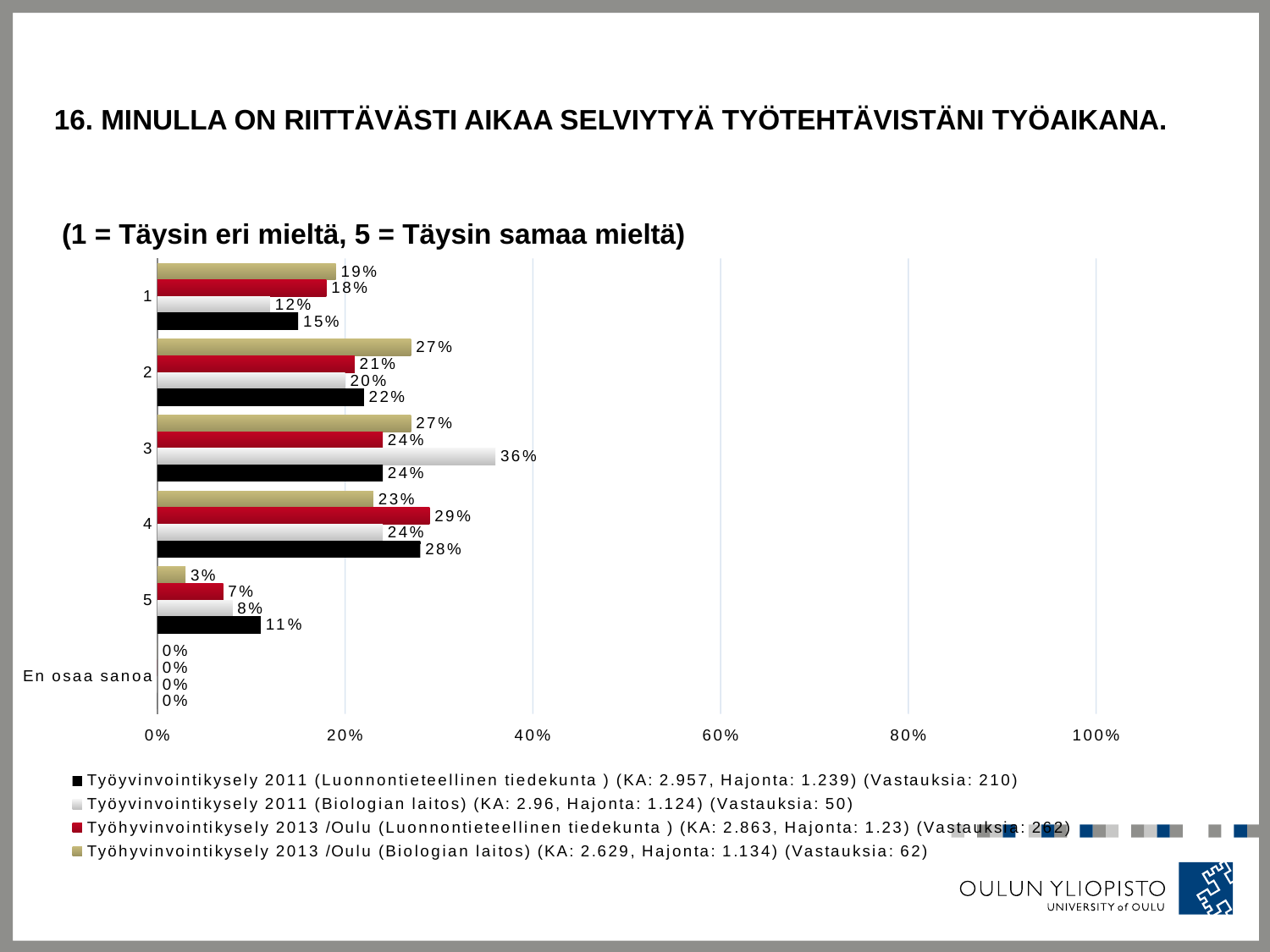
How many categories are shown on the vertical axis? 6 What is the value for category 1 in the Työyvinvointikysely 2011 (Luonnontieteellinen tiedekunta) series? 15% What kind of chart is shown on the slide? Bar chart What is the value for category 3 in the Työyvinvointikysely 2011 (Biologian laitos) series? 36% Which category has the lowest non-zero value in the Työhyvinvointikysely 2013 /Oulu (Biologian laitos) series? 5 What is the value for category 5 in the Työhyvinvointikysely 2013 /Oulu (Biologian laitos) series? 3% For category 4, which is larger: the Työhyvinvointikysely 2013 /Oulu (Luonnontieteellinen tiedekunta) value or the Työhyvinvointikysely 2013 /Oulu (Biologian laitos) value? Työhyvinvointikysely 2013 /Oulu (Luonnontieteellinen tiedekunta) What is the value for category 4 in the Työhyvinvointikysely 2013 /Oulu (Luonnontieteellinen tiedekunta) series? 29% Is the value for category 3 in the Työyvinvointikysely 2011 (Biologian laitos) series greater or less than 20%? greater Which category has the highest value in the Työyvinvointikysely 2011 (Biologian laitos) series? 3 How many series does the legend list? 4 What is the difference between the Työyvinvointikysely 2011 (Biologian laitos) value and the Työhyvinvointikysely 2013 /Oulu (Biologian laitos) value for category 3? 9%